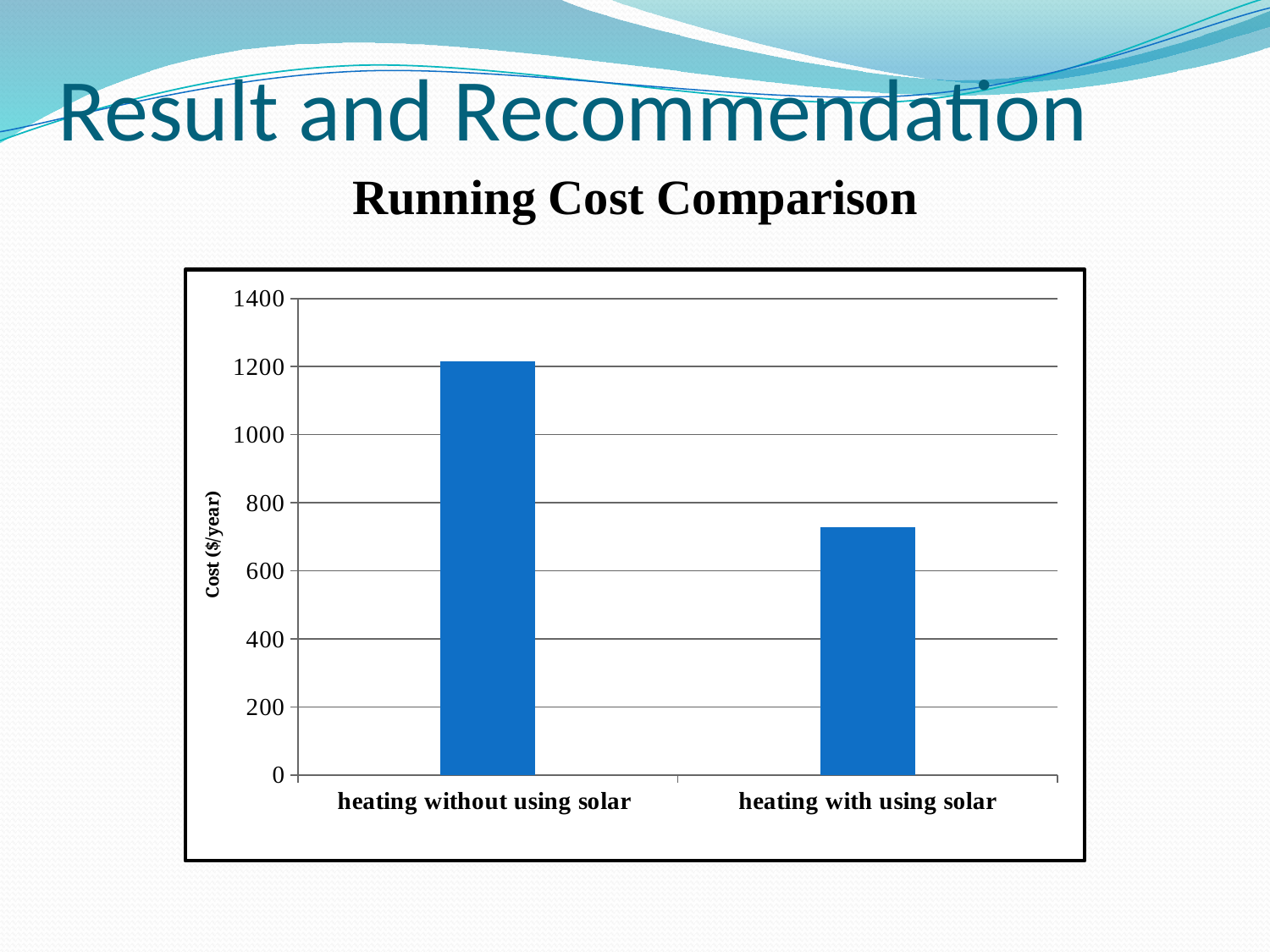
Which category has the lowest running cost? heating with using solar Do the values fall or rise from the left category to the right category? fall Is the value for heating with using solar greater or less than 800? less What type of chart is shown on the slide? bar chart How many categories are shown on the x axis of the chart? 2 Is the value for heating without using solar greater or less than 1000? greater What is the label of the vertical axis? Cost ($/year) What is the title of the chart? Running Cost Comparison Which category has the highest running cost? heating without using solar Is the value for heating without using solar greater or less than 1400? less Which is larger, the cost for heating without using solar or heating with using solar? heating without using solar